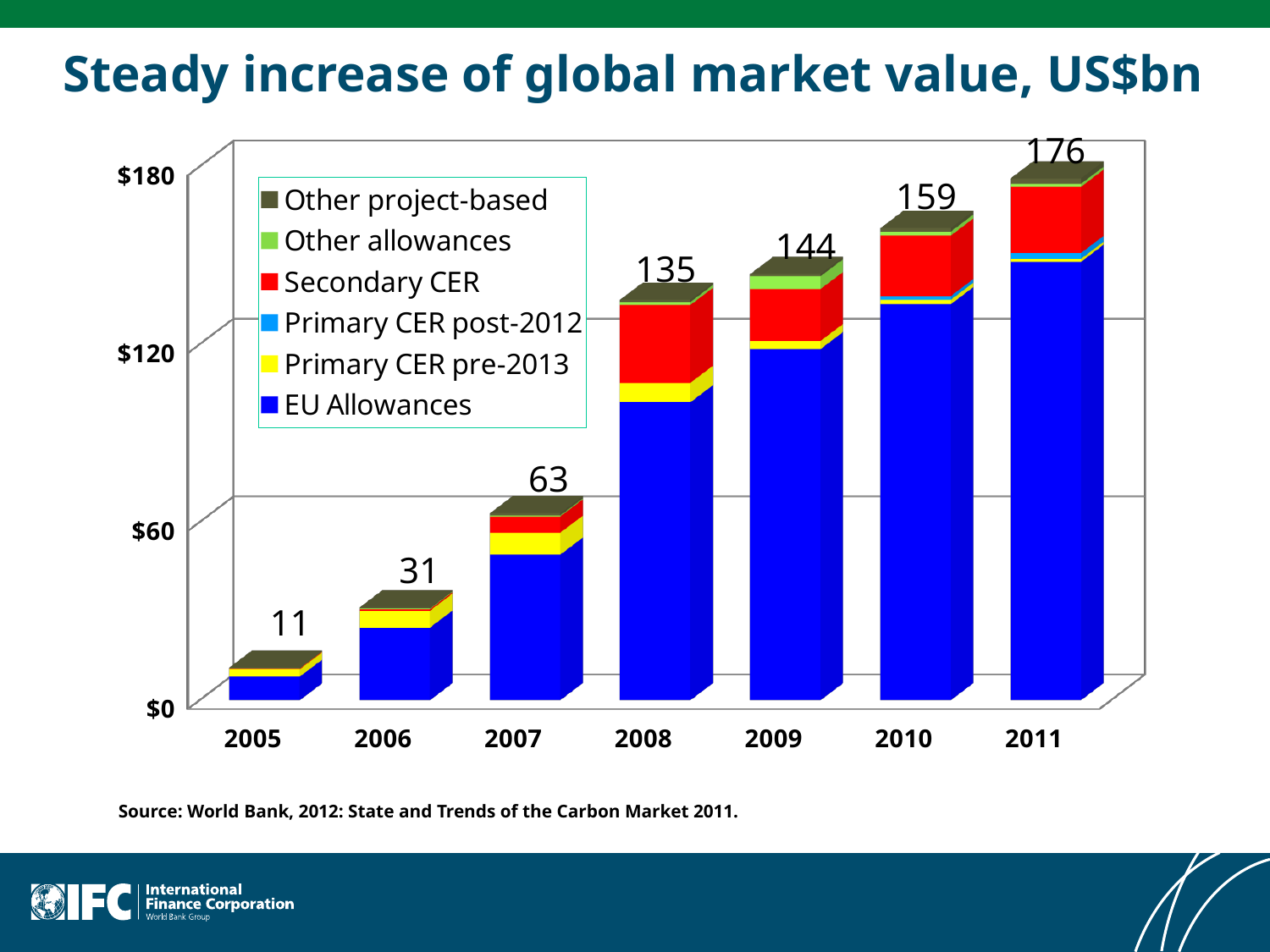
What is the total value labelled on the bar for 2005? 11 Do the total values rise or fall from 2005 to 2011? rise Is the EU Allowances segment for 2011 greater or less than $120? greater Which year has a larger total value, 2009 or 2010? 2010 What is the total value labelled on the bar for 2008? 135 Which year has the lowest total market value? 2005 What is the difference between the total values for 2011 and 2010? 17 What is the difference between the total values for 2008 and 2007? 72 How many years are shown on the x axis? 7 What is the total global market value shown for 2011? 176 How many series does the legend list? 6 Which year has the highest total market value? 2011